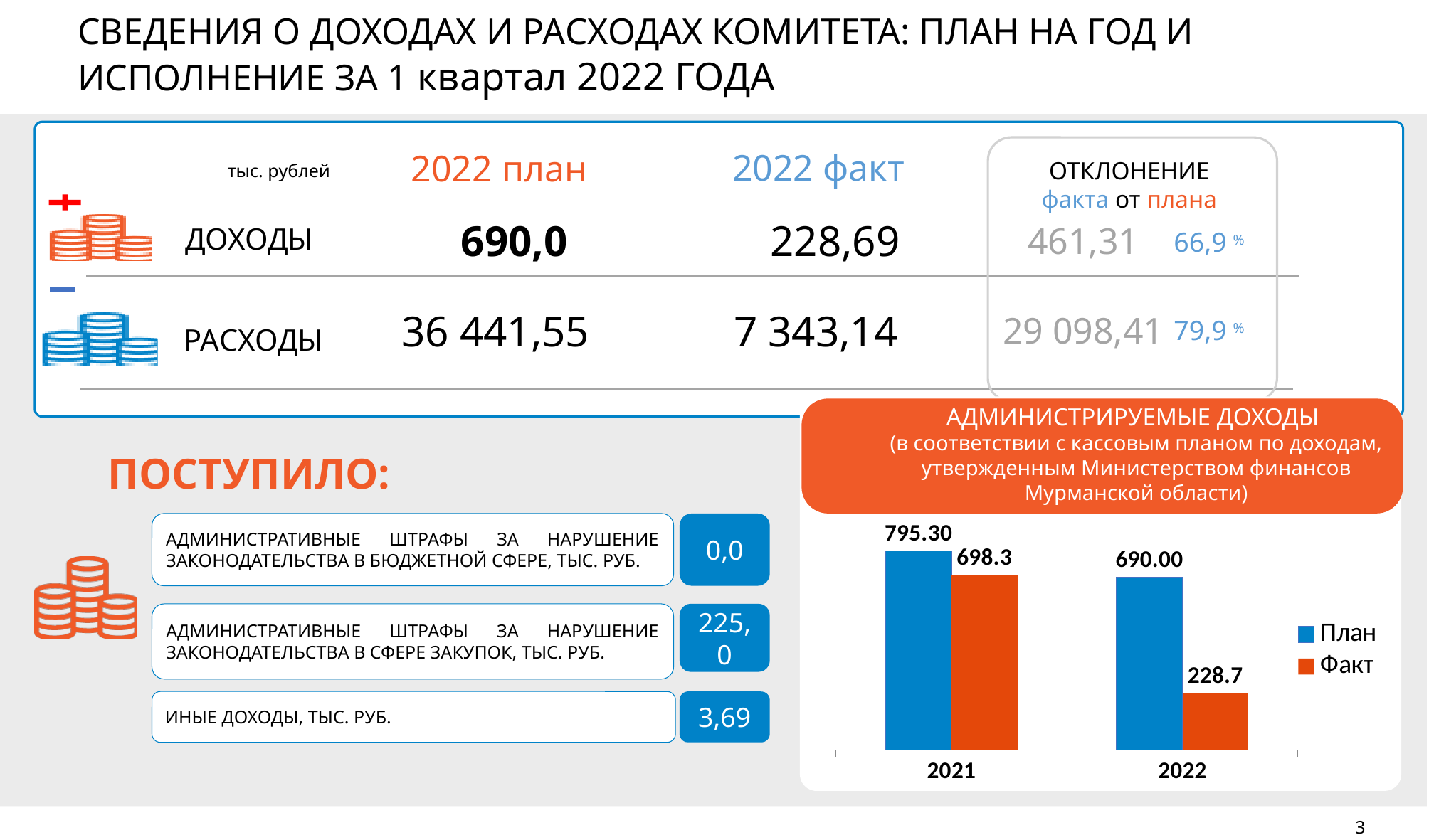
How many categories are shown on the x axis of the chart? 2 Which bar in the chart has the highest value? План 2021 What is the value of the План series for 2022 in the chart? 690.00 What is the value of the Факт series for 2021 in the chart? 698.3 What type of chart is shown on the slide? Bar chart What is the difference between the План and Факт values for 2022 in the chart? 461.3 What is the value of the План series for 2021 in the chart? 795.30 What is the value of the Факт series for 2022 in the chart? 228.7 What is the difference between the План values for 2021 and 2022 in the chart? 105.3 How many series does the chart legend list? 2 Which bar in the chart has the lowest value? Факт 2022 Which year has the higher Факт value in the chart? 2021